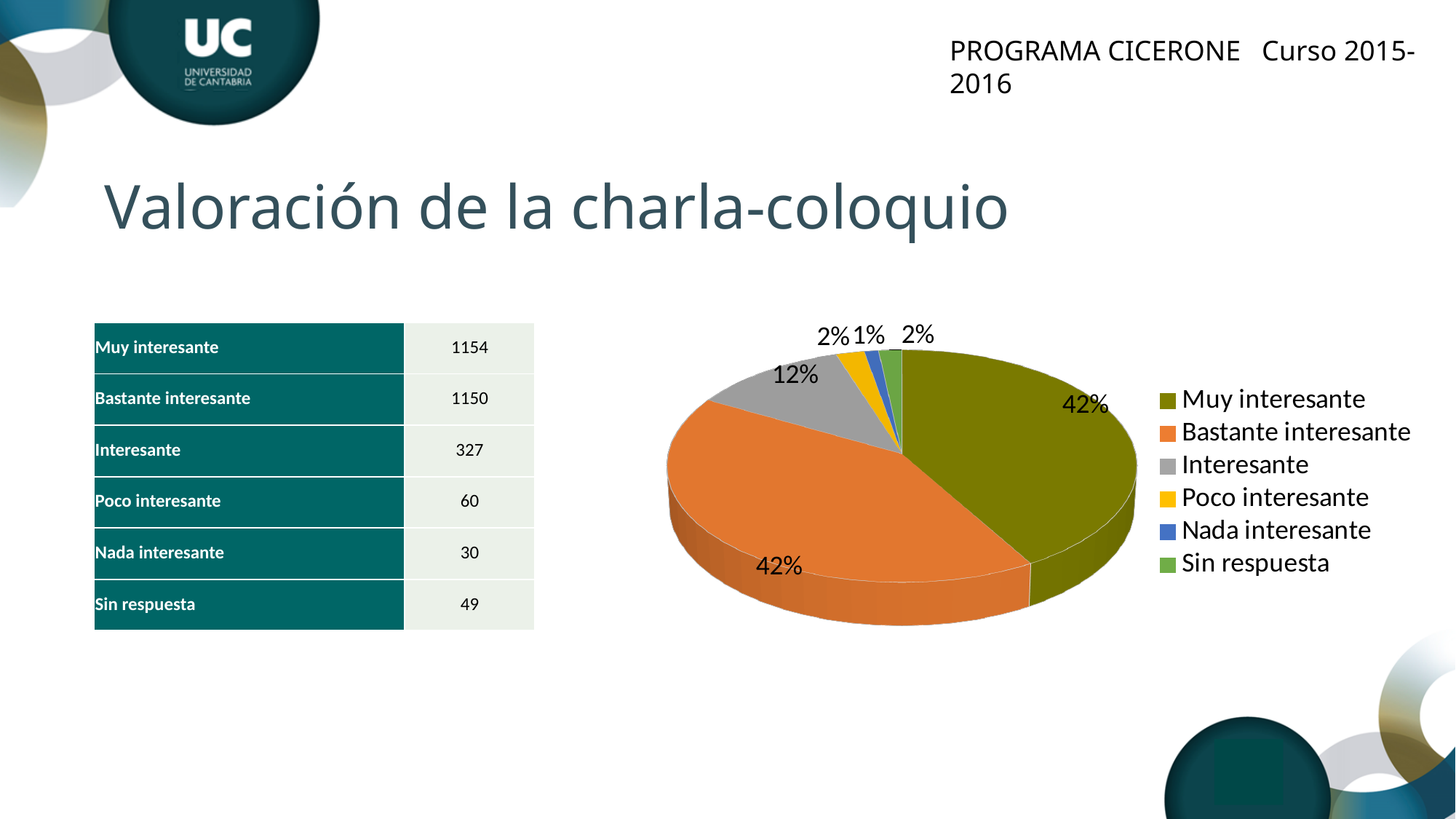
Which category is shown in grey in the pie chart legend? Interesante Which category has the smallest slice in the pie chart? Nada interesante How many categories does the legend of the pie chart list? 6 Which slice is larger in the pie chart, "Interesante" or "Poco interesante"? Interesante What type of chart is shown on the slide? pie chart What percentage is shown for "Muy interesante" in the pie chart? 42% What percentage is shown for "Nada interesante" in the pie chart? 1% What colour is the "Bastante interesante" slice in the pie chart? orange What percentage is shown for "Sin respuesta" in the pie chart? 2% What share of the pie chart does "Interesante" represent? 12% What is the difference in percentage points between the "Interesante" slice and the "Poco interesante" slice? 10 What percentage is shown for "Bastante interesante" in the pie chart? 42%